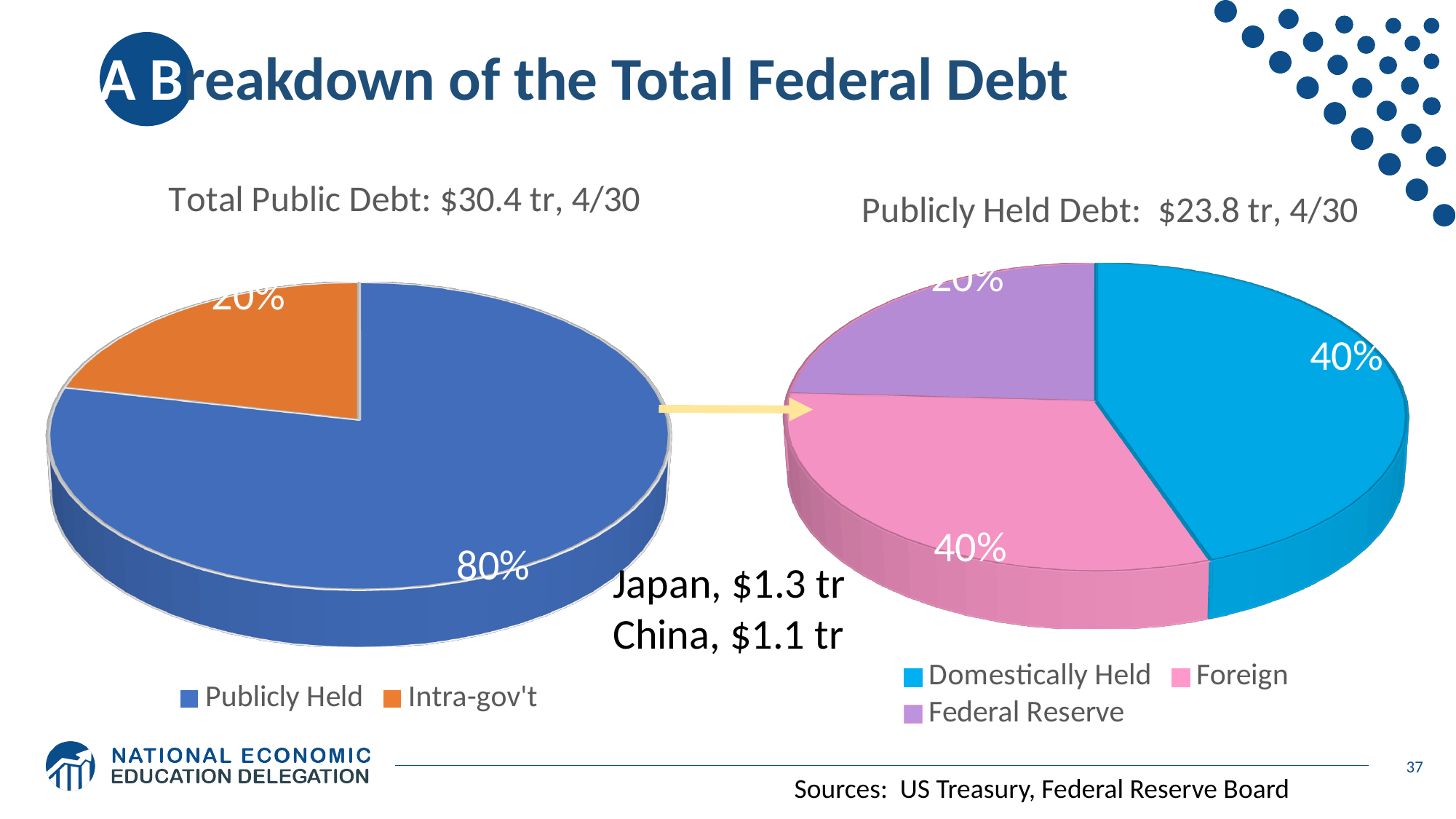
In the Total Public Debt chart, what is the difference in percentage points between the Publicly Held and Intra-gov't slices? 60 How many entries does the legend of the Total Public Debt chart list? 2 In the Publicly Held Debt chart, which is larger, the Domestically Held slice or the Federal Reserve slice? Domestically Held In the Total Public Debt chart, which slice is the largest? Publicly Held In the Publicly Held Debt chart, which slice is the smallest? Federal Reserve In the Total Public Debt chart, what share of the pie is Publicly Held? 80% In the Publicly Held Debt chart, what share of the pie is Foreign? 40% In the Publicly Held Debt chart, what share of the pie is Federal Reserve? 20% What total amount is stated in the title of the chart on the right? $23.8 tr How many slices does the Publicly Held Debt chart have? 3 What kind of chart is the chart on the left of the slide? Pie chart